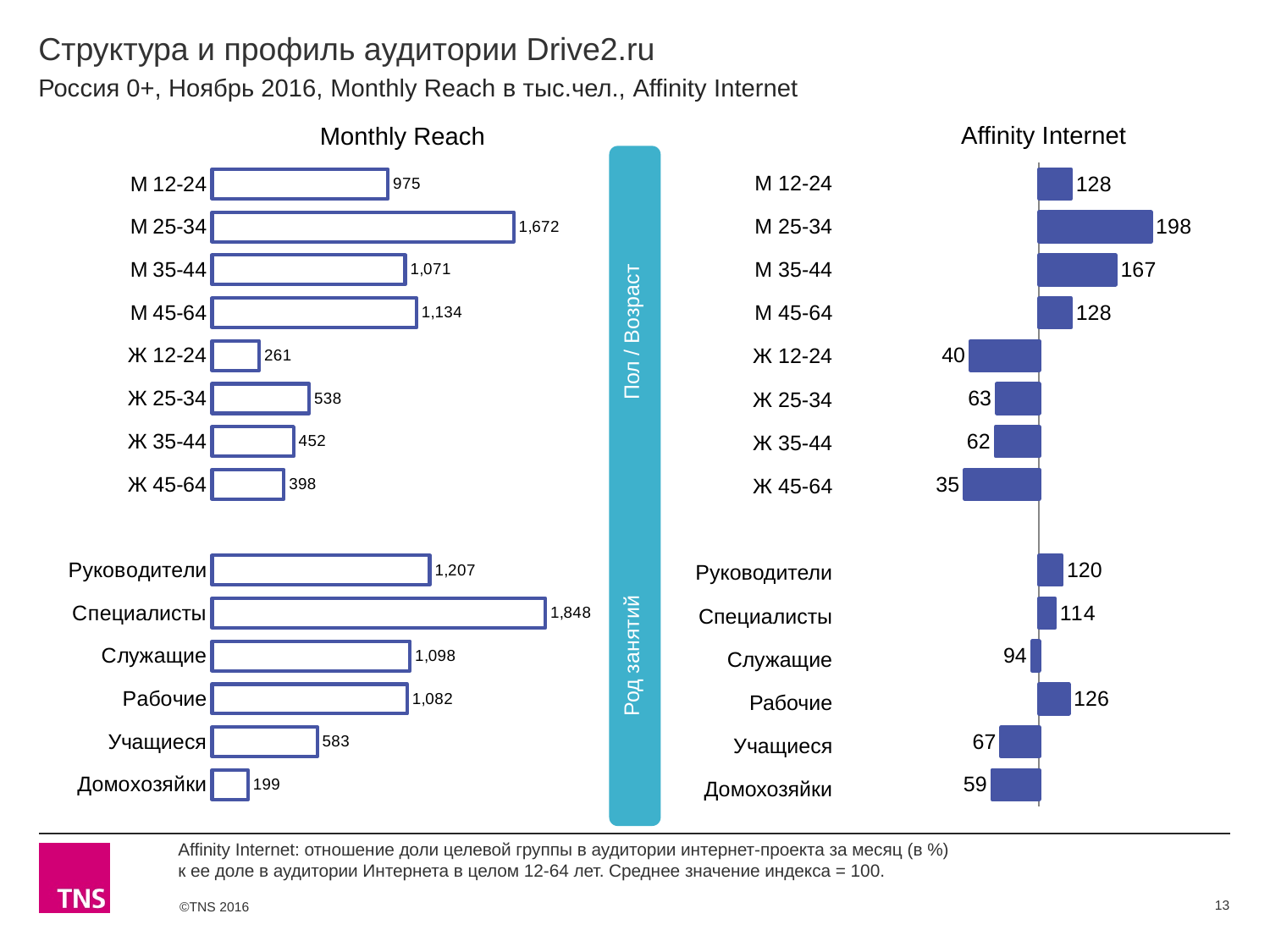
In the Monthly Reach chart, what is the value for М 25-34? 1,672 In the Monthly Reach chart, what is the difference between Специалисты and Руководители? 641 In the Monthly Reach chart, which is larger: Ж 25-34 or Учащиеся? Учащиеся In the Affinity Internet chart, what is the value for Рабочие? 126 In the Affinity Internet chart, what is the value for Ж 45-64? 35 In the Affinity Internet chart, which category has the highest value? М 25-34 What type of chart is the Monthly Reach chart? Bar chart In the Affinity Internet chart, which is larger: М 35-44 or М 45-64? М 35-44 In the Monthly Reach chart, which category has the highest value? Специалисты In the Monthly Reach chart, what is the value for Домохозяйки? 199 In the Affinity Internet chart, which category has the lowest value? Ж 45-64 How many categories are shown in the Affinity Internet chart? 14